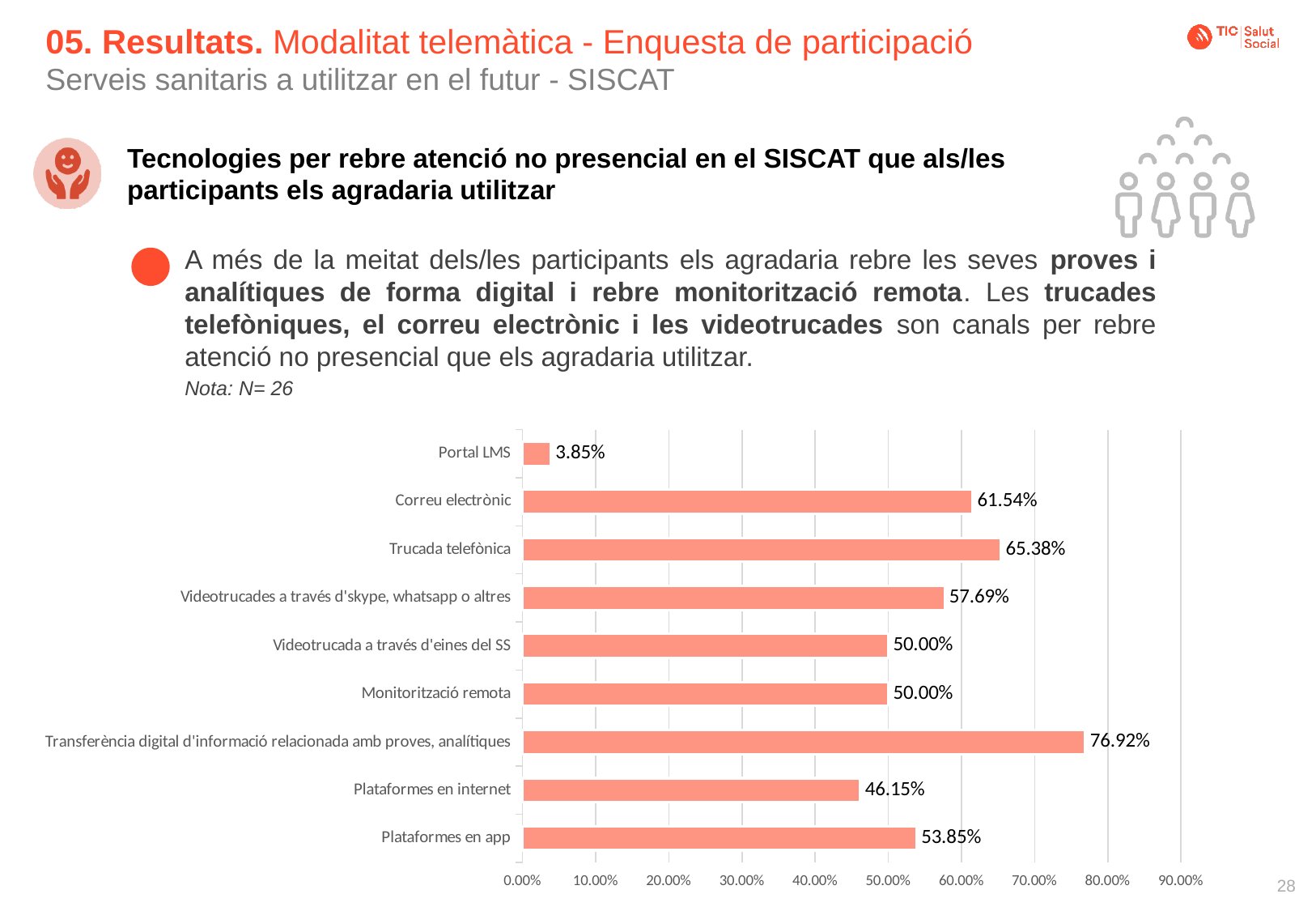
Is the value for Videotrucades a través d'skype, whatsapp o altres greater or less than 50.00%? greater Which is larger, Plataformes en internet or Plataformes en app? Plataformes en app Which category has the lowest value? Portal LMS How many categories are shown in the chart? 9 Which category has the highest value? Transferència digital d'informació relacionada amb proves, analítiques What is the difference between Transferència digital d'informació relacionada amb proves, analítiques and Portal LMS? 73.07% What is the value for Monitorització remota? 50.00% What is the value for Plataformes en app? 53.85% What is the value for Portal LMS? 3.85% What is the value for Correu electrònic? 61.54% What kind of chart is shown on the slide? bar chart What is the difference between Trucada telefònica and Correu electrònic? 3.84%